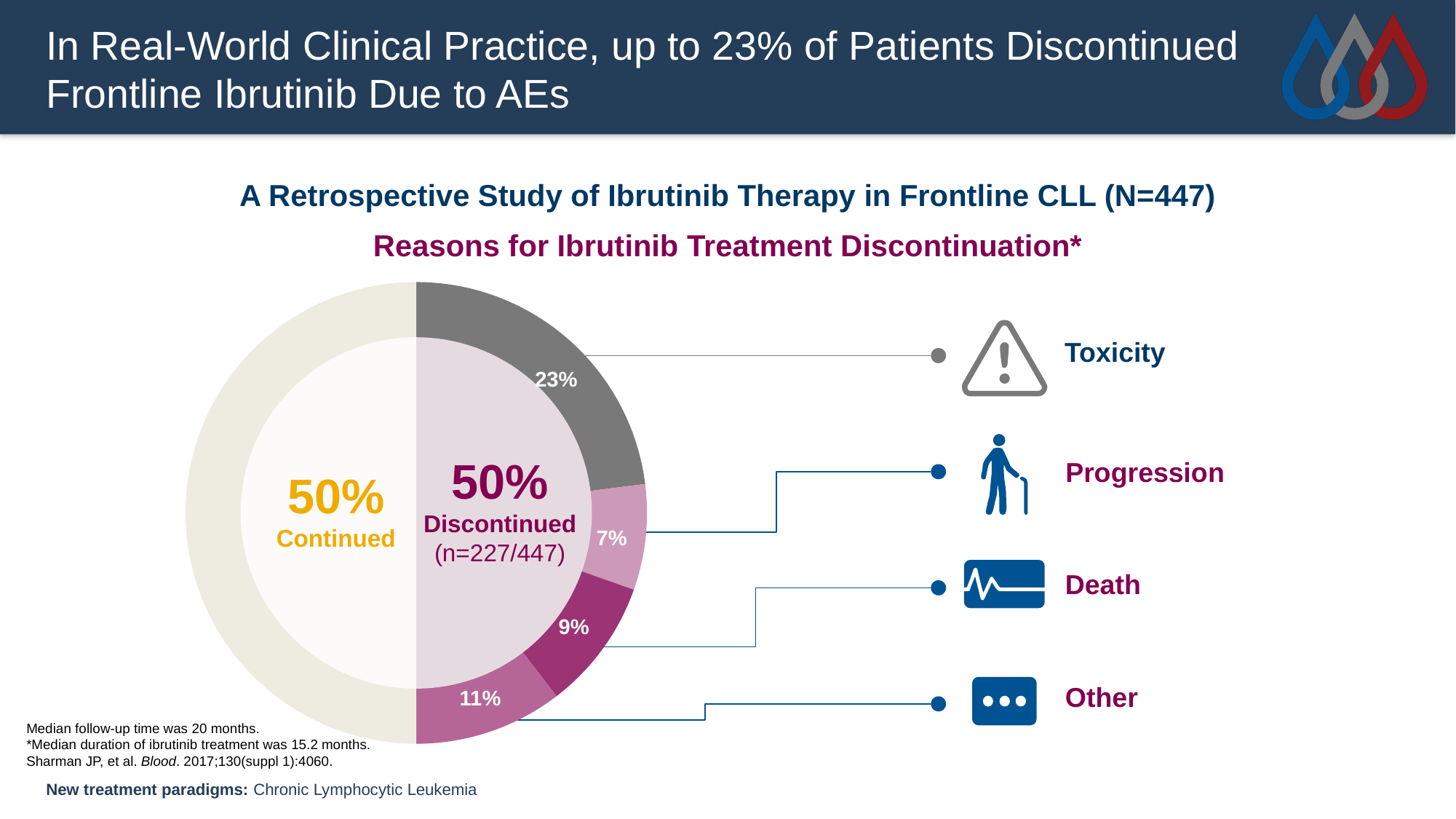
How many patients discontinued ibrutinib, as shown in the chart (n)? n=227/447 What kind of chart is shown on the slide? Pie chart (donut) What percentage of patients continued ibrutinib? 50% Which reason for discontinuation accounts for the smallest share? Progression What percentage of patients discontinued ibrutinib due to toxicity? 23% What percentage of patients discontinued ibrutinib due to progression? 7% What percentage of patients discontinued ibrutinib due to death? 9% Which reason for discontinuation accounts for the largest share? Toxicity What is the difference between the toxicity and progression discontinuation percentages? 16% Which is larger, the share for death or the share for other? Other How many reasons for discontinuation are shown in the chart? 4 What percentage of patients discontinued ibrutinib for 'Other' reasons? 11%